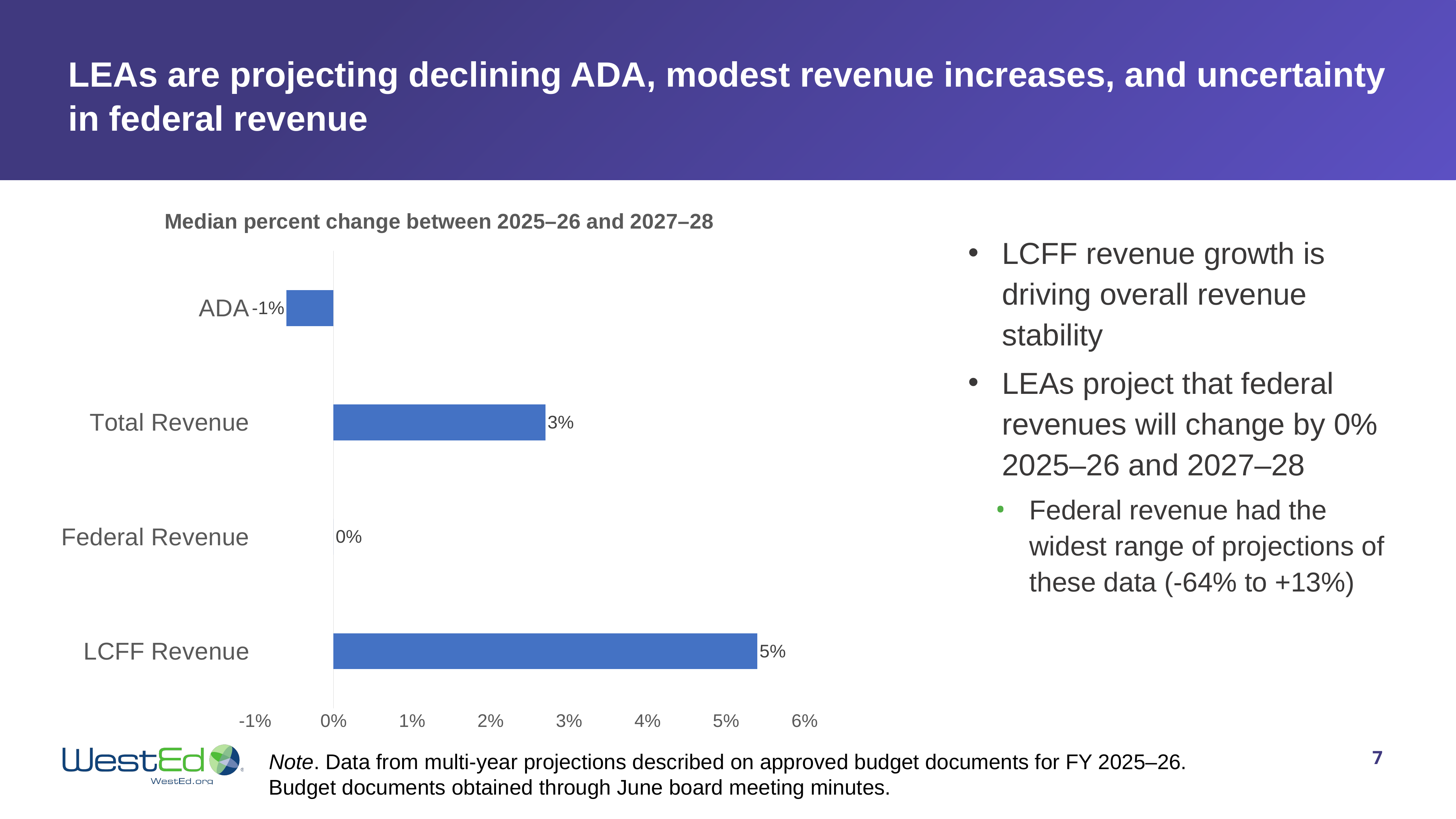
What kind of chart is shown on the slide? Bar chart What is the median percent change for LCFF Revenue? 5% Is the value for LCFF Revenue greater or less than 4%? greater What is the median percent change for Total Revenue? 3% Which is larger, the median percent change for Total Revenue or for Federal Revenue? Total Revenue How many categories are shown in the chart? 4 What is the median percent change for Federal Revenue? 0% What is the median percent change for ADA? -1% Which category has the highest median percent change? LCFF Revenue Which category has the lowest median percent change? ADA What is the title of the chart? Median percent change between 2025–26 and 2027–28 What is the difference between the median percent change for LCFF Revenue and Total Revenue? 2%